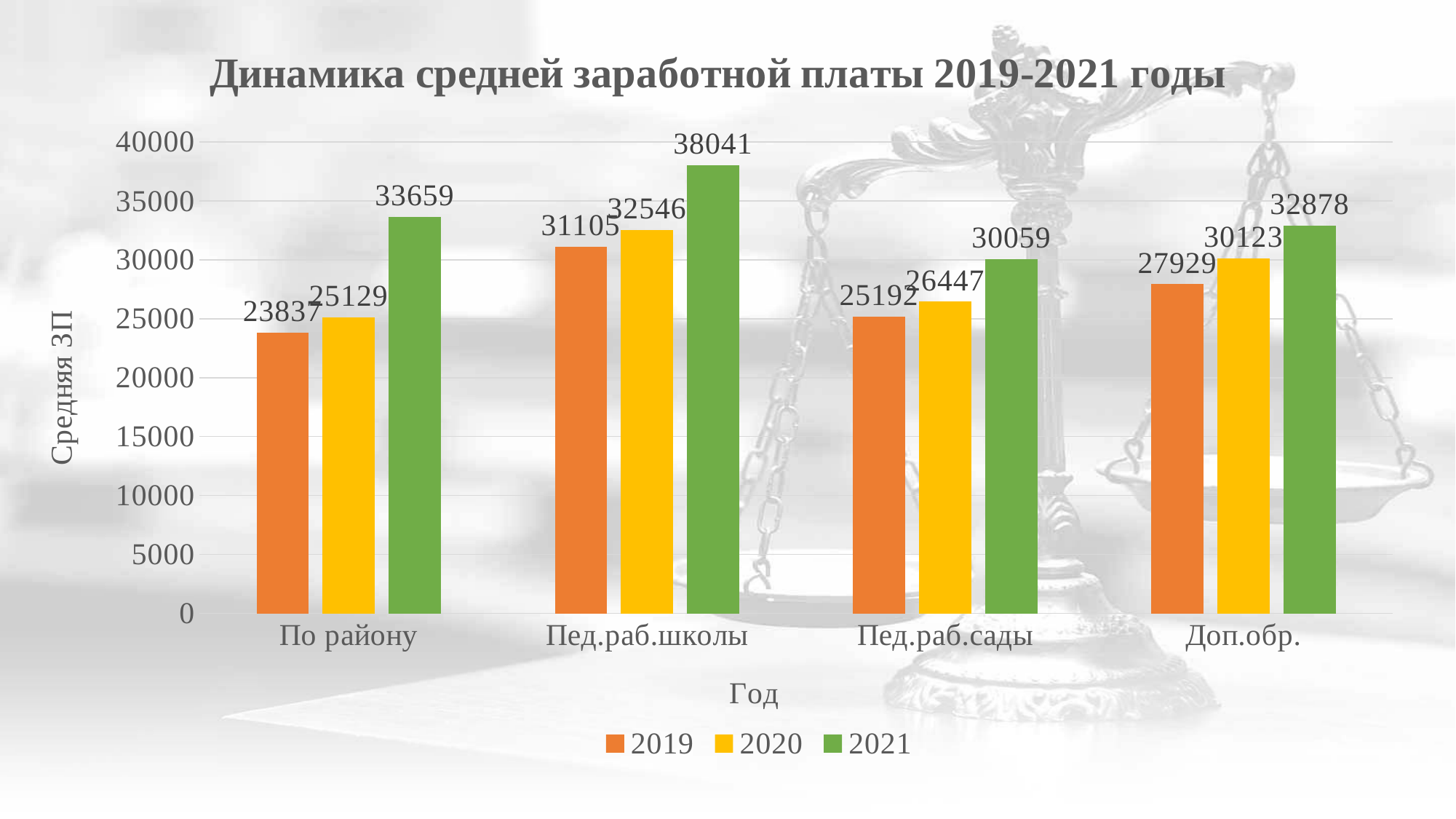
Which category has the lowest value in the 2019 series? По району Which category has the highest value in the 2021 series? Пед.раб.школы Which is larger: the 2020 value for Пед.раб.сады or the 2020 value for Доп.обр.? Доп.обр. Is the 2019 value for Пед.раб.школы greater or less than 30000? greater What is the value for По району in the 2019 series? 23837 What is the difference between the 2021 and 2019 values for По району? 9822 What is the value for Пед.раб.школы in the 2021 series? 38041 What is the value for Доп.обр. in the 2020 series? 30123 How many categories are shown on the x axis? 4 What is the title of the chart? Динамика средней заработной платы 2019-2021 годы How many series does the legend list? 3 What kind of chart is shown on the slide? bar chart